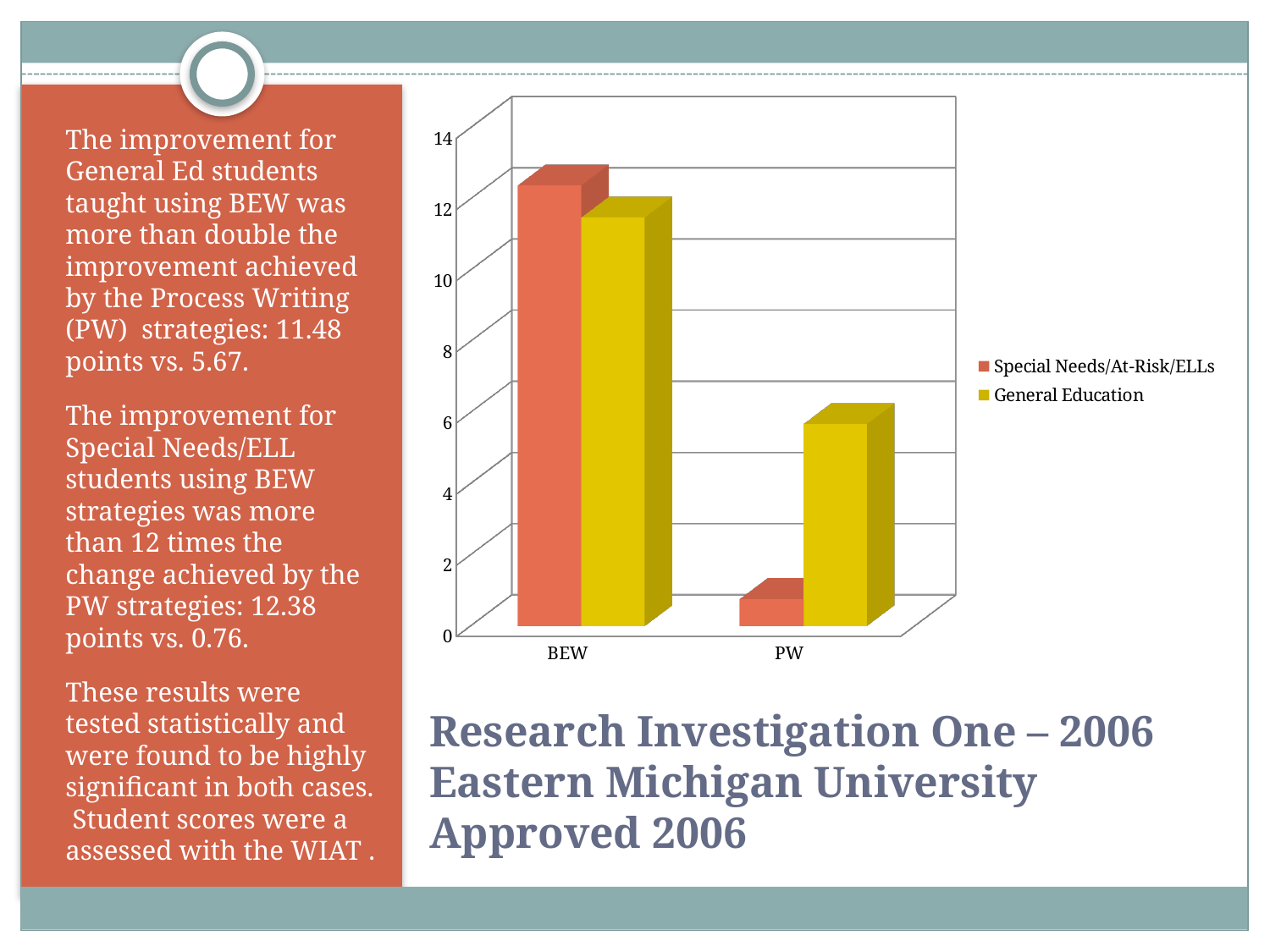
Do the values for General Education rise or fall from BEW to PW? fall Is the value for Special Needs/At-Risk/ELLs in the PW category greater or less than 2? less What kind of chart is shown on the slide? bar chart For the BEW category, which series has the larger value: Special Needs/At-Risk/ELLs or General Education? Special Needs/At-Risk/ELLs Is the value for General Education in the PW category greater or less than 8? less Which series has the lowest bar in the chart? Special Needs/At-Risk/ELLs How many categories are shown on the x axis of the chart? 2 What are the two series named in the chart legend? Special Needs/At-Risk/ELLs and General Education Is the value for Special Needs/At-Risk/ELLs in the BEW category greater or less than 10? greater How many series does the chart legend list? 2 For the PW category, which series has the larger value: Special Needs/At-Risk/ELLs or General Education? General Education Which category has the tallest bar in the chart? BEW